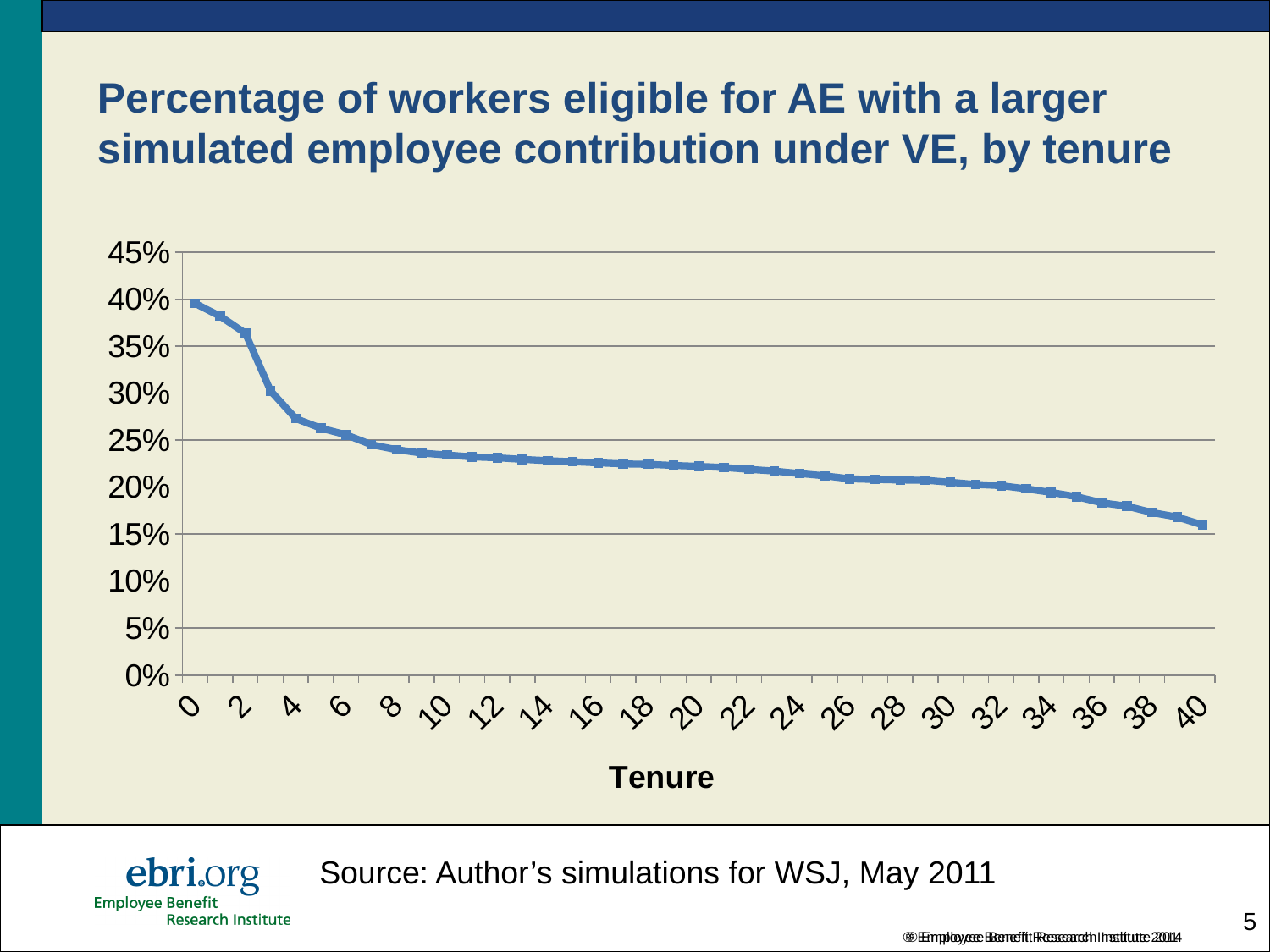
Which has a larger value, tenure 4 or tenure 20? Tenure 4 What is the label of the x axis? Tenure What kind of chart is shown on the slide? Line chart At which tenure is the percentage of workers highest? 0 Is the value at tenure 10 greater or less than 25%? less Is the value at tenure 0 greater or less than 35%? greater At which tenure is the percentage of workers lowest? 40 What is the title of the chart? Percentage of workers eligible for AE with a larger simulated employee contribution under VE, by tenure Do the values rise or fall as tenure increases along the x axis? Fall Is the value at tenure 36 greater or less than 20%? less